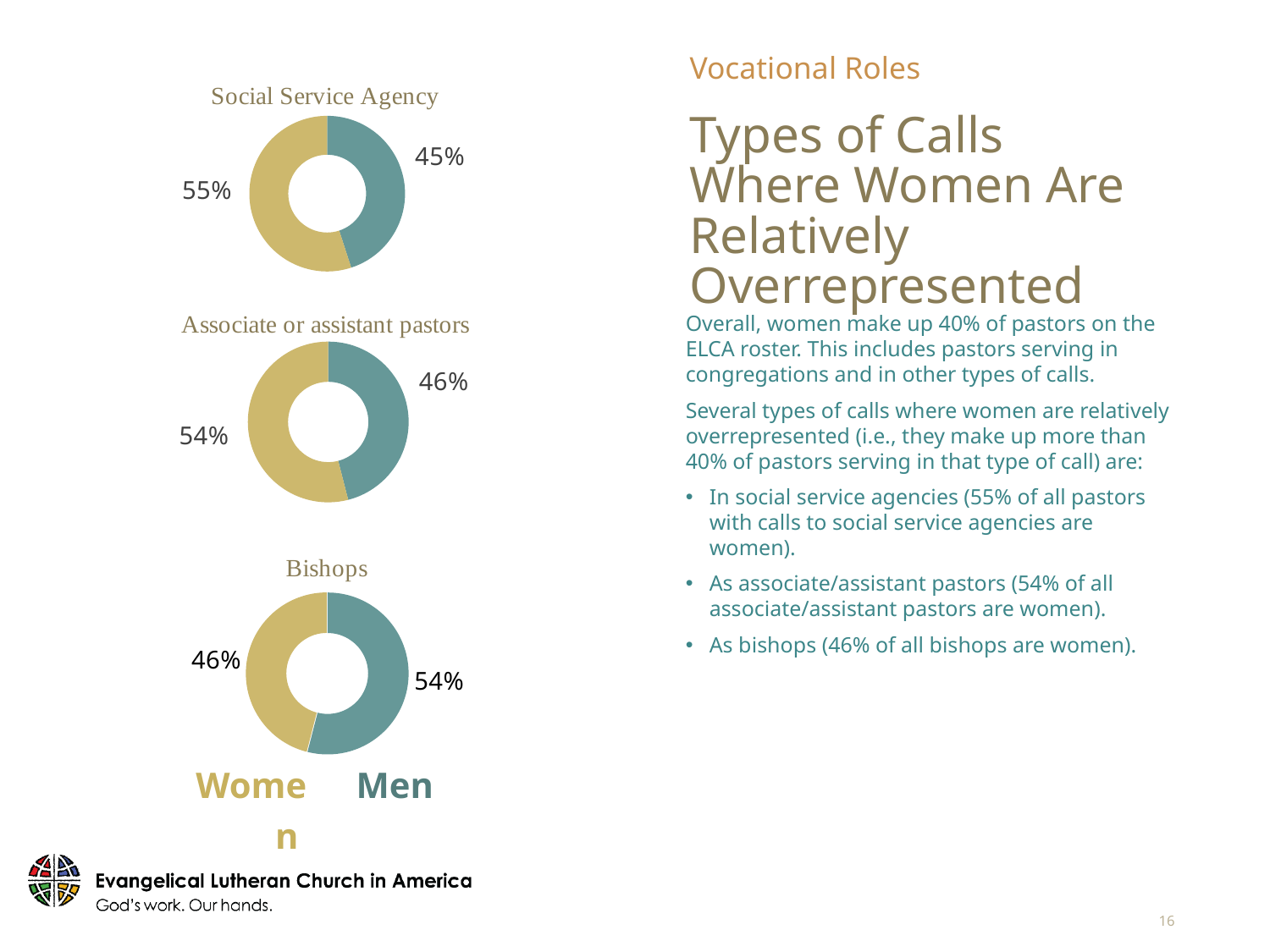
In the Associate or assistant pastors chart, what is the difference in percentage points between Women and Men? 8 How many charts are shown on the slide? 3 In the Social Service Agency chart, what percentage is shown for Men? 45% In the Associate or assistant pastors chart, what percentage is shown for Women? 54% What kind of chart is used for the Bishops data? Donut (pie) chart In the Bishops chart, which group has the larger share, Women or Men? Men In the Associate or assistant pastors chart, which group has the larger share, Women or Men? Women In the Social Service Agency chart, what percentage is shown for Women? 55% How many groups does the legend list for the charts? 2 In the Bishops chart, what percentage is shown for Women? 46% In the Social Service Agency chart, what is the difference in percentage points between Women and Men? 10 In the Bishops chart, what percentage is shown for Men? 54%